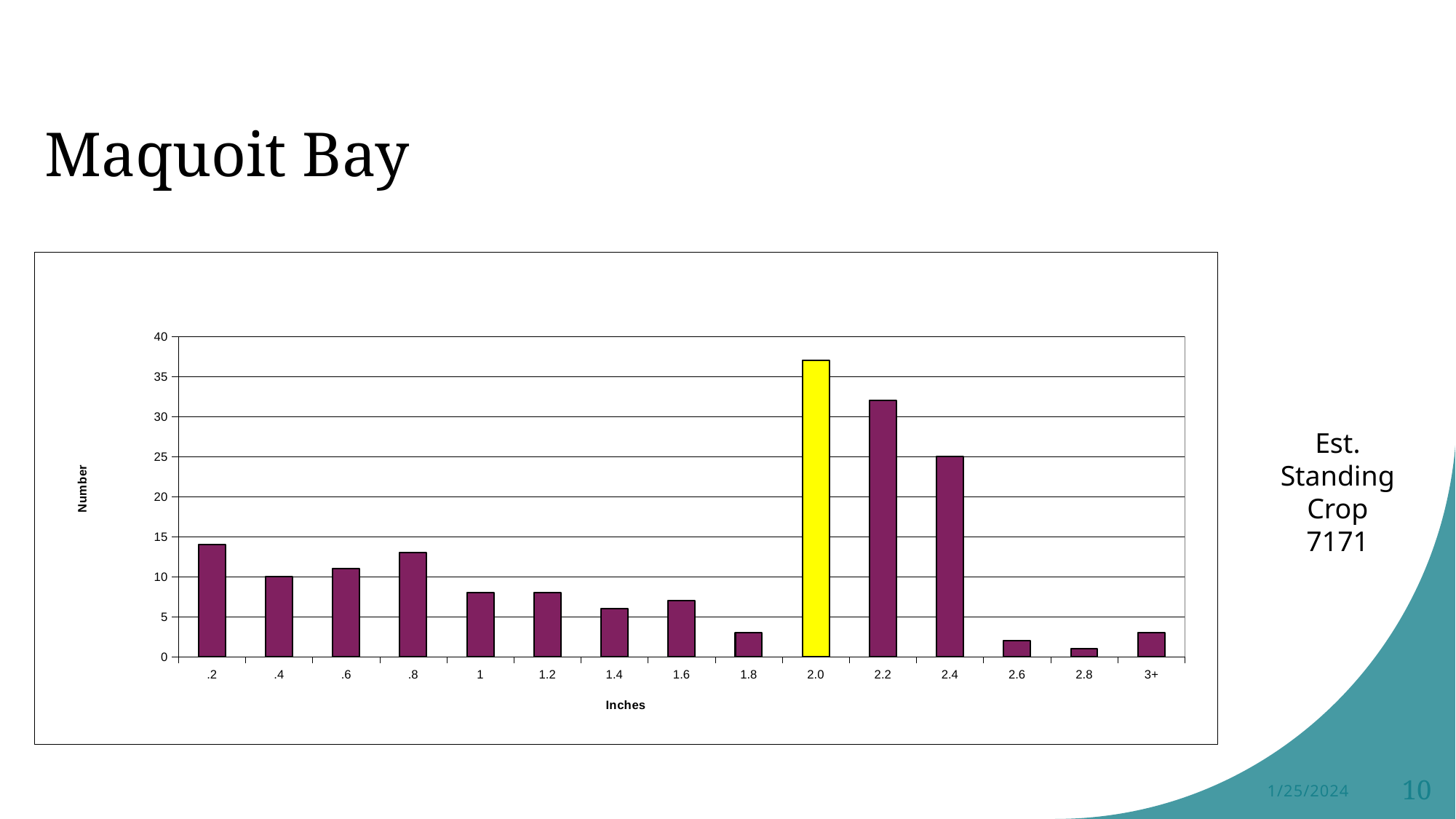
What is the value for the .4 category? 10 Which is larger, the value for .2 or the value for 1? .2 What kind of chart is shown on the slide? bar chart Which category has the highest bar in the chart? 2.0 Is the value for 2.0 greater or less than 35? greater What is the label of the x axis? Inches Is the value for 1.8 greater or less than 5? less What is the value for the 2.4 category? 25 How many categories are shown on the x axis of the chart? 15 What colour is the bar for the 2.0 category? yellow Which category has the lowest bar in the chart? 2.8 Is the value for 2.2 greater or less than 30? greater